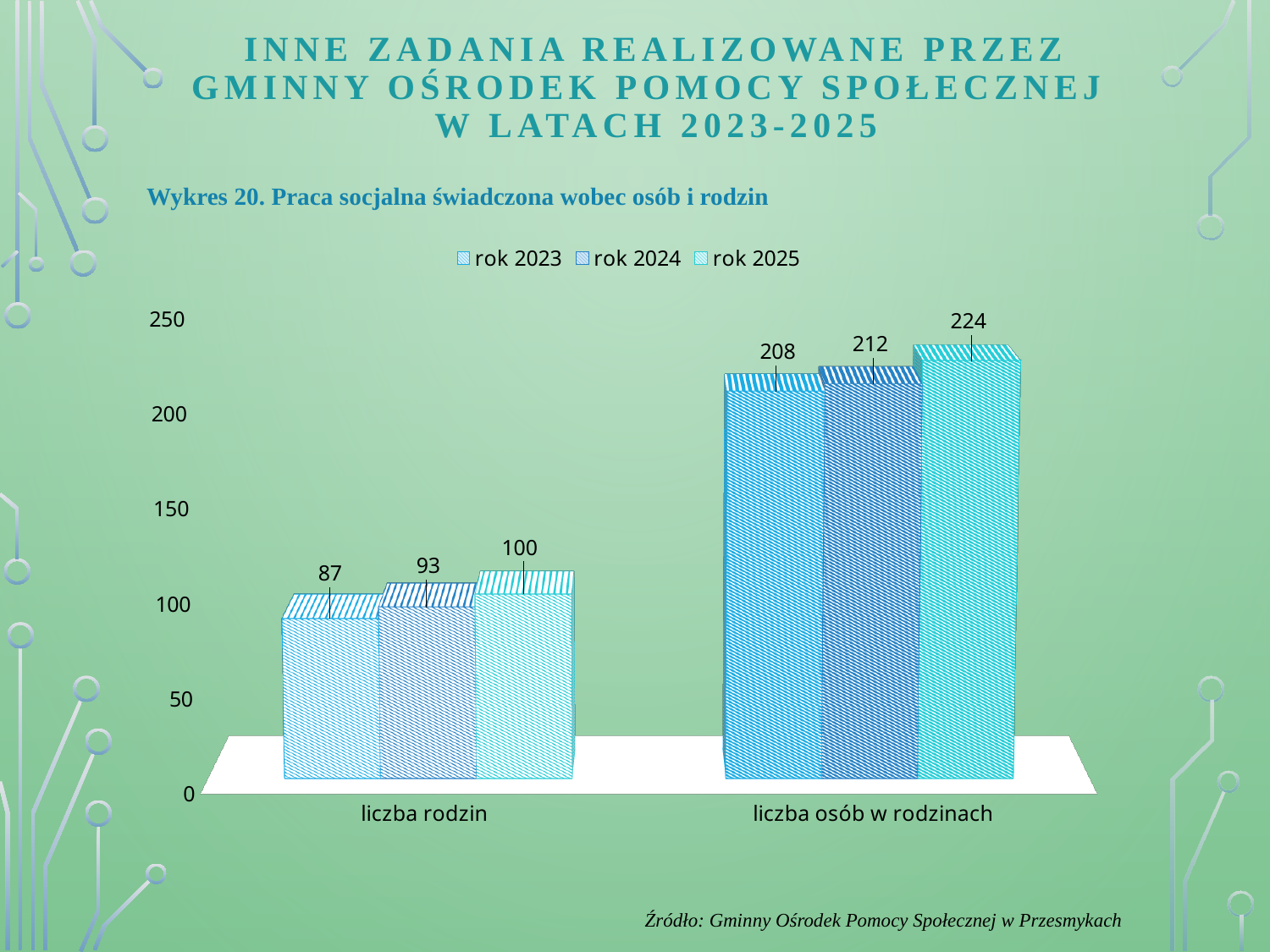
How many series does the legend list? 3 What is the value for 'liczba rodzin' in rok 2025? 100 What is the value for 'liczba rodzin' in rok 2023? 87 Which year has the lowest value for 'liczba rodzin'? rok 2023 Do the values for 'liczba rodzin' rise or fall from rok 2023 to rok 2025? rise What is the difference between the rok 2025 and rok 2023 values for 'liczba osób w rodzinach'? 16 What is the value for 'liczba osób w rodzinach' in rok 2024? 212 What kind of chart is shown on the slide? bar chart Which year has the highest value for 'liczba osób w rodzinach'? rok 2025 What is the value for 'liczba osób w rodzinach' in rok 2025? 224 Which is larger: 'liczba rodzin' in rok 2025 or 'liczba osób w rodzinach' in rok 2023? liczba osób w rodzinach in rok 2023 What is the difference between the rok 2024 and rok 2023 values for 'liczba rodzin'? 6